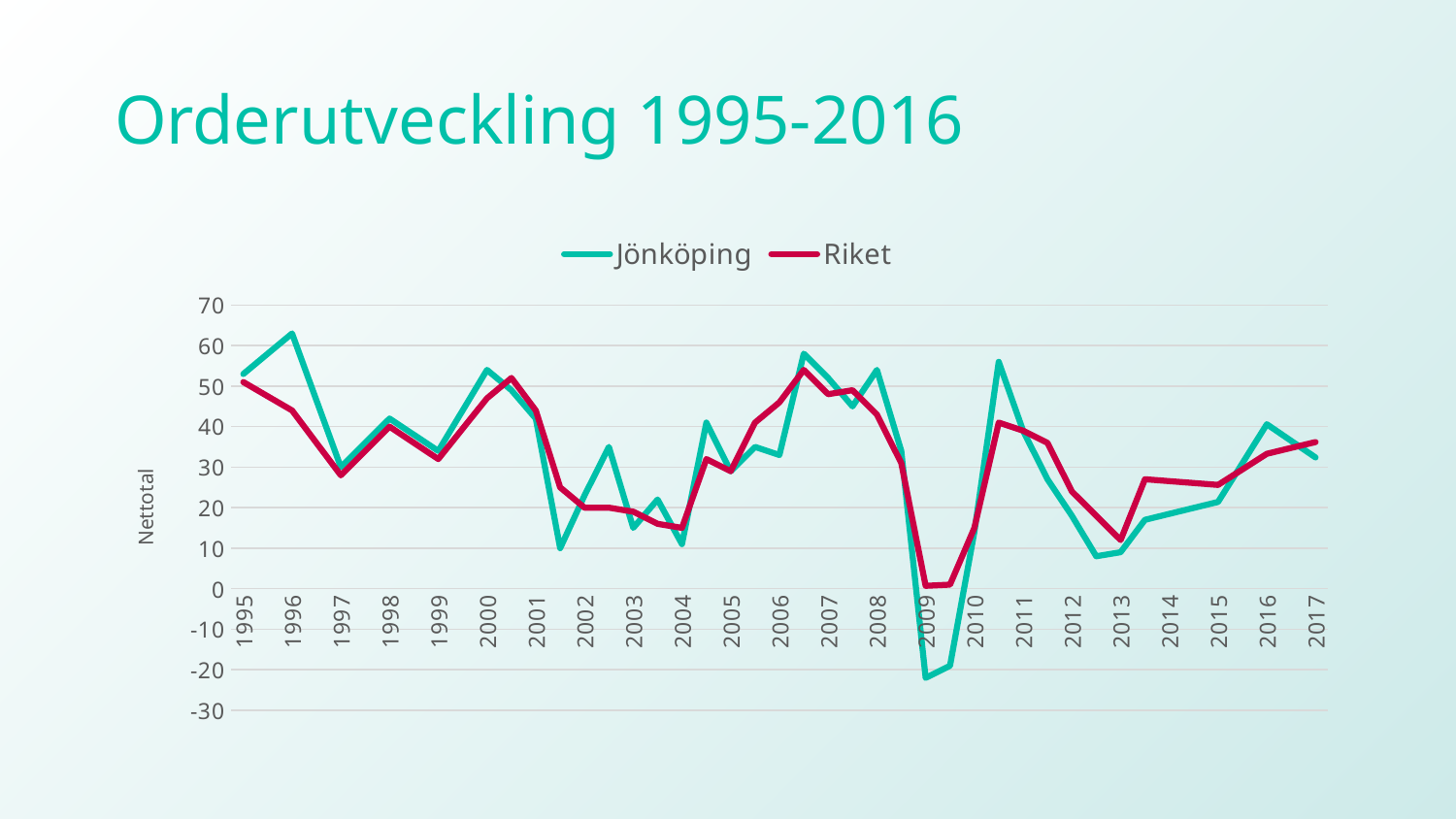
What are the two series named in the legend? Jönköping and Riket Is the lowest value of the Jönköping series greater or less than -10? less Which series reaches the highest value anywhere on the chart? Jönköping Is the highest value of the Riket series greater or less than 60? less What is the title of the chart on the slide? Orderutveckling 1995-2016 How many year labels are shown on the x axis? 23 How many series does the legend list? 2 Which series reaches the lowest value anywhere on the chart? Jönköping Does the Riket series rise or fall between 2013 and 2017? Rise Around 2009, which series is lower, Jönköping or Riket? Jönköping What kind of chart is shown on the slide? Line chart Is the highest value of the Jönköping series greater or less than 60? greater